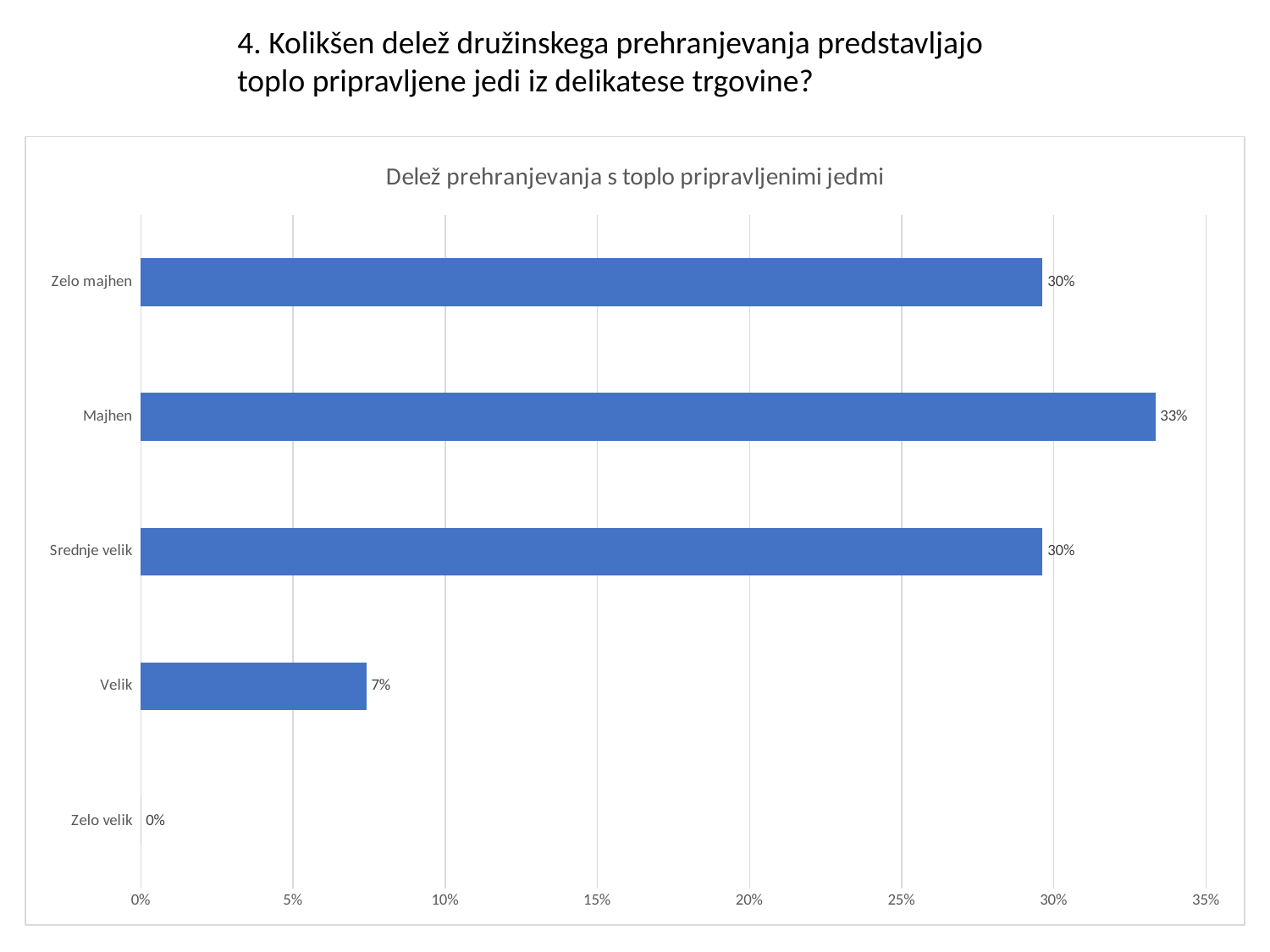
Which category has the highest value? Majhen What is the value for Velik? 7% Which category has the lowest value? Zelo velik What is the value for Srednje velik? 30% Which is larger, the value for Zelo majhen or the value for Velik? Zelo majhen What is the difference between the values for Majhen and Velik? 26% What kind of chart is shown on the slide? bar chart Is the value for Velik greater or less than 10%? less What is the value for Majhen? 33% What is the title of the chart? Delež prehranjevanja s toplo pripravljenimi jedmi What is the value for Zelo velik? 0% How many categories are shown in the chart? 5